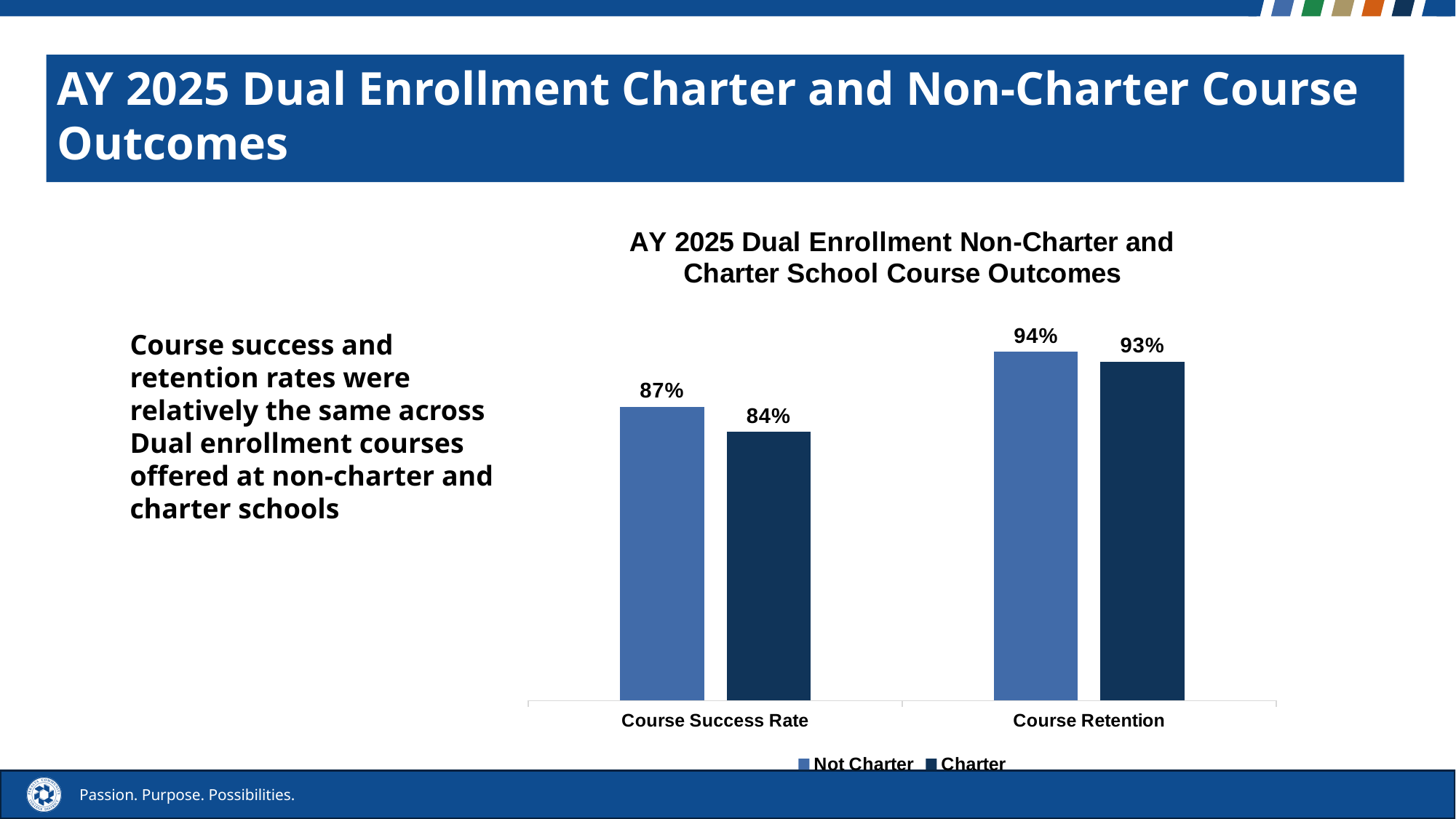
What is the Course Retention value for Charter? 93% Which series has the higher Course Success Rate, Not Charter or Charter? Not Charter What is the difference between the Not Charter and Charter Course Retention values? 1% What is the Course Success Rate for Not Charter? 87% How many categories are shown on the x axis? 2 How many series does the legend list? 2 Which category has the lowest value for the Not Charter series? Course Success Rate What is the Course Success Rate for Charter? 84% What is the difference between the Not Charter and Charter Course Success Rates? 3% Which category has the highest value for the Charter series? Course Retention What is the Course Retention value for Not Charter? 94% What kind of chart is shown on the slide? Bar chart